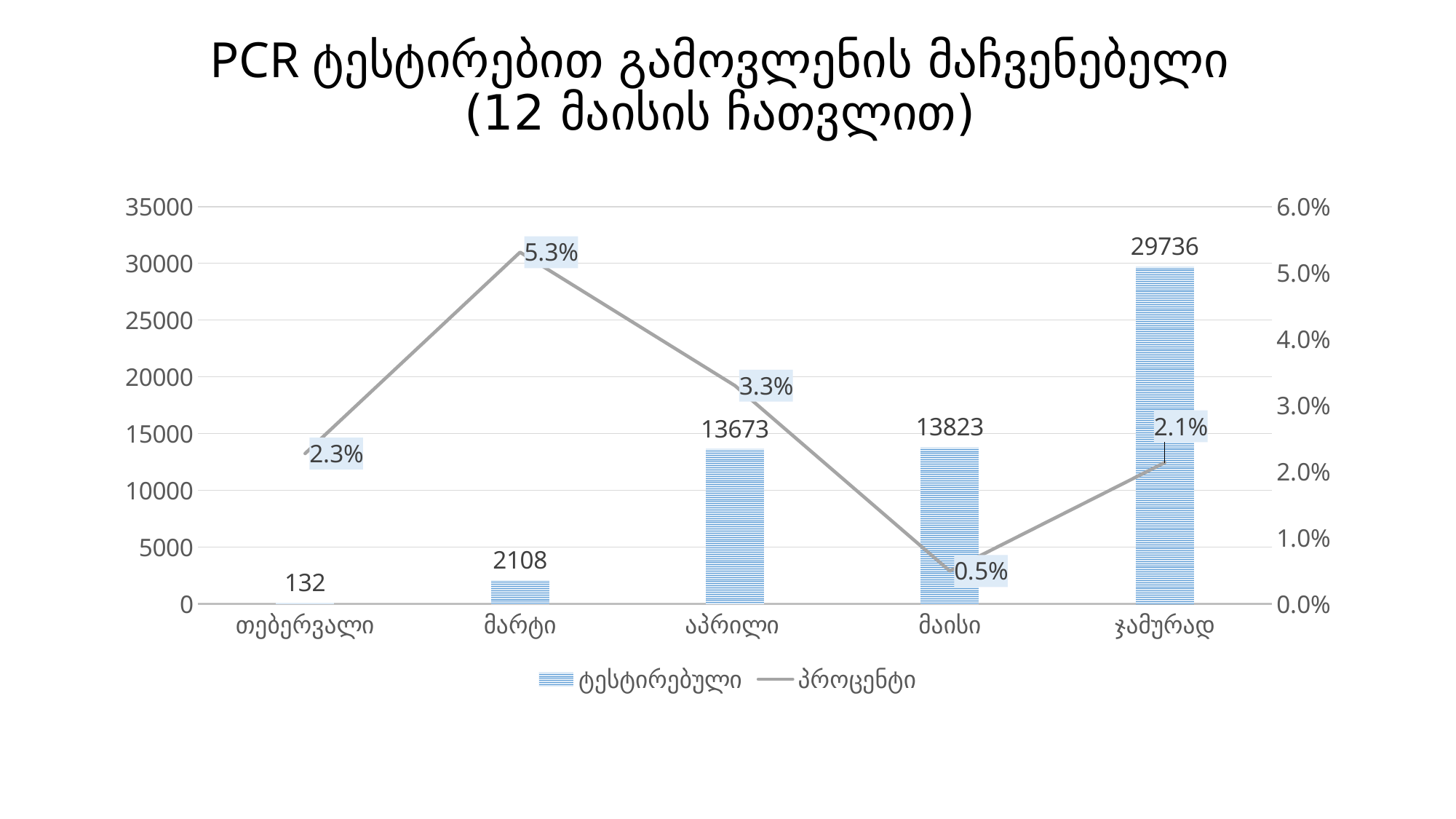
Which category has the highest ტესტირებული value? ჯამურად Which series is drawn as a line? პროცენტი How many categories are shown on the x axis? 5 What is the value of ტესტირებული for მარტი? 2108 Which category has the lowest პროცენტი value? მაისი What kind of chart is shown on the slide? Combined bar and line chart What is the difference between the ტესტირებული values for მაისი and აპრილი? 150 Which is larger, the პროცენტი value for თებერვალი or for ჯამურად? თებერვალი What is the value of ტესტირებული for აპრილი? 13673 What is the პროცენტი value for მარტი? 5.3% What is the პროცენტი value for მაისი? 0.5% How many series does the legend list? 2